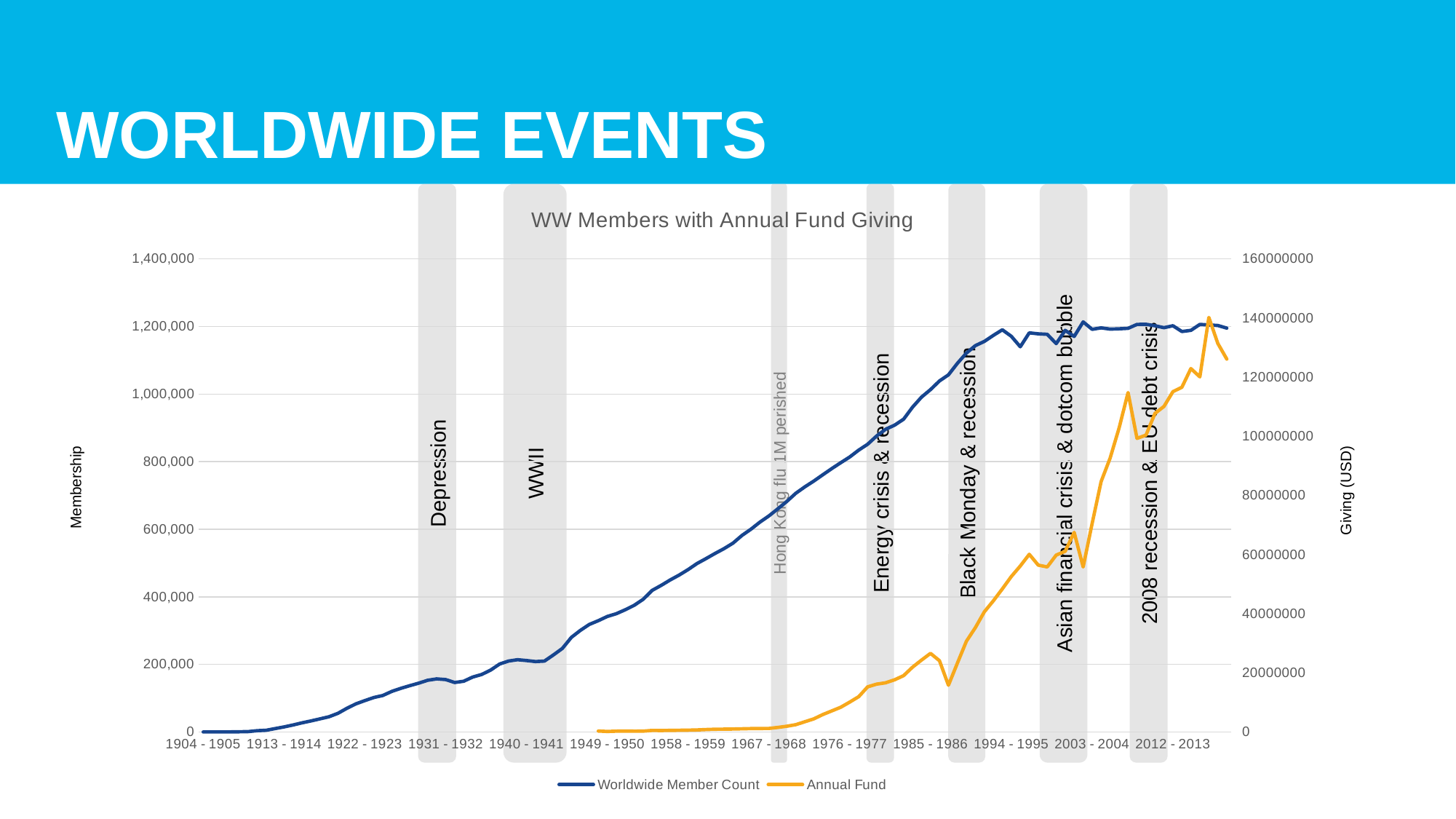
Is the Annual Fund value for 1949 - 1950 greater or less than 20000000? less How many period labels are shown on the x axis? 13 Is the Worldwide Member Count for 1994 - 1995 greater or less than 1,000,000? greater Which series is drawn in orange? Annual Fund How many series does the legend list? 2 Is the Worldwide Member Count for 1958 - 1959 greater or less than 600,000? less What is the title of the chart? WW Members with Annual Fund Giving Which is larger, the Worldwide Member Count for 1922 - 1923 or for 1994 - 1995? 1994 - 1995 Does the Worldwide Member Count generally rise or fall from 1904 - 1905 to 1994 - 1995? rise What kind of chart is shown on the slide? Line chart